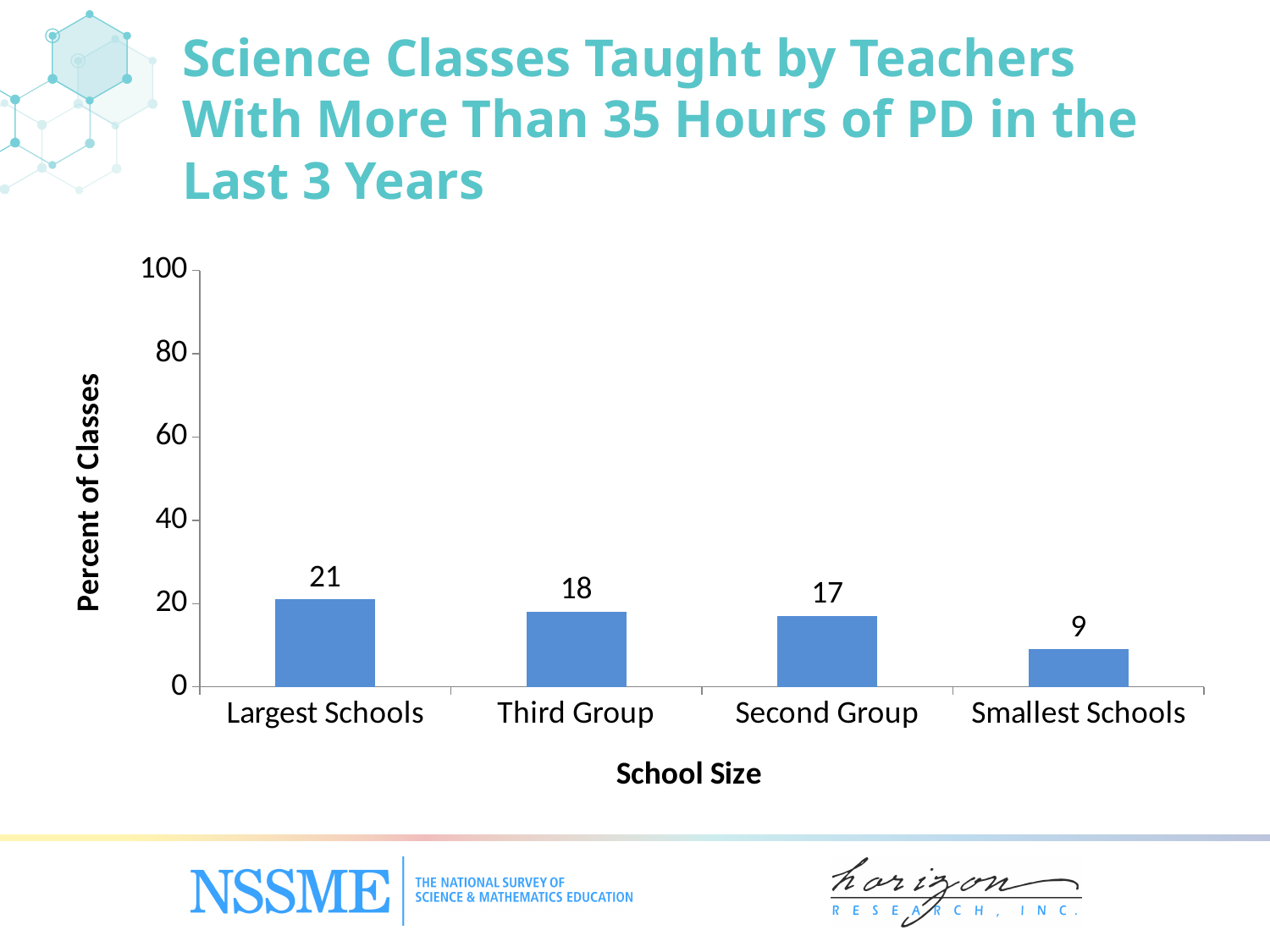
What is the value for Smallest Schools? 9 Which school size category has the lowest percent of classes? Smallest Schools What is the difference between the values for Third Group and Second Group? 1 Which school size category has the highest percent of classes? Largest Schools How many school size categories are shown on the chart? 4 What kind of chart is shown on the slide? bar chart What is the difference between the values for Largest Schools and Smallest Schools? 12 What is the value for Largest Schools? 21 Which is larger, the value for Third Group or the value for Smallest Schools? Third Group What is the value for Second Group? 17 What is the label of the y axis? Percent of Classes Is the value for Largest Schools greater or less than 40? less